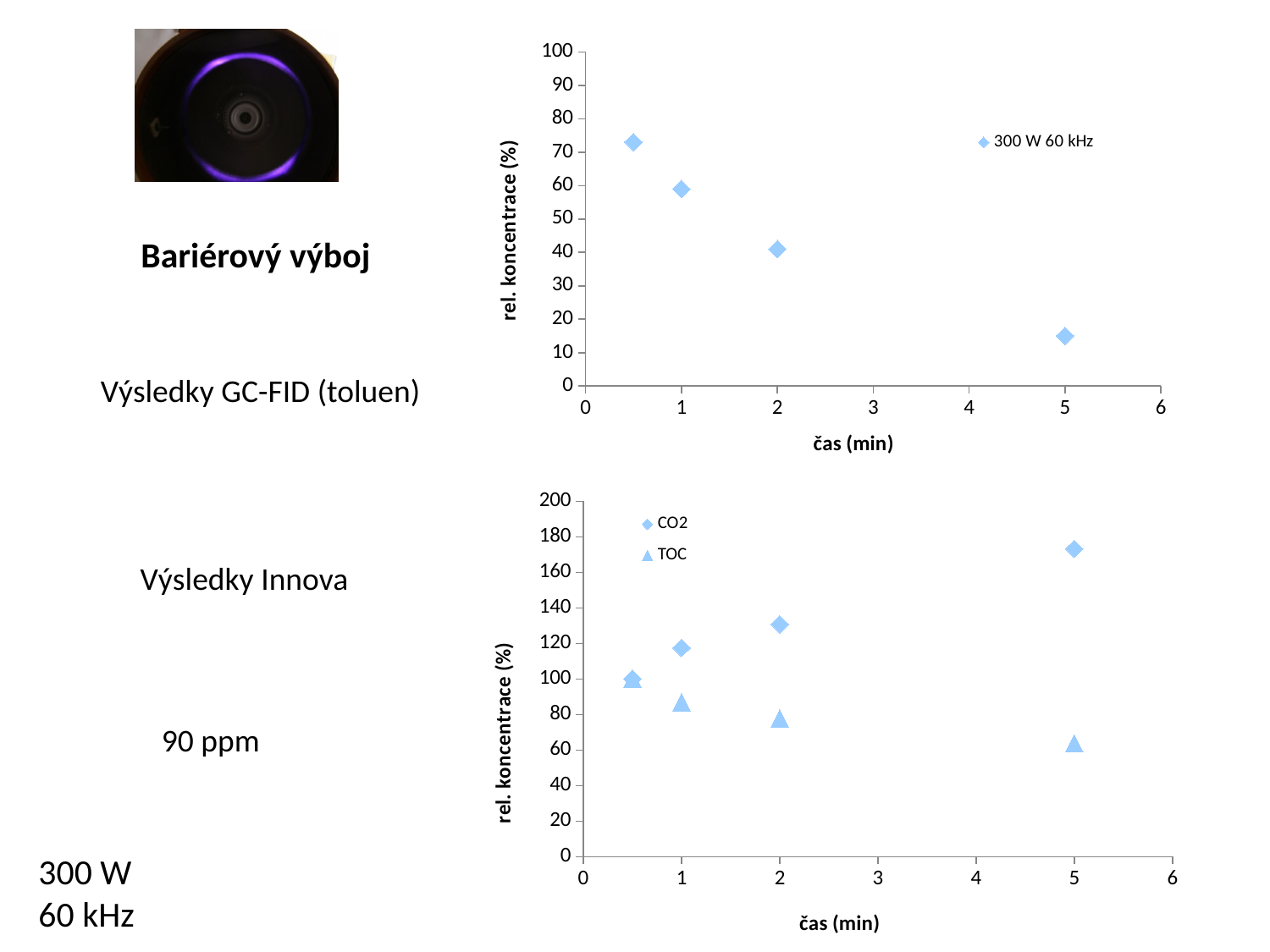
In the bottom chart, is the CO2 value at 5 min greater or less than 160? greater How many series does the legend of the bottom chart list? 2 What is the name of the series in the top chart's legend? 300 W 60 kHz In the top chart, is the value at 5 min greater or less than 20? less What is the x-axis title of the bottom chart? čas (min) What kind of chart is the top chart on the slide? scatter chart In the top chart, is the value at 0.5 min greater or less than 70? greater In the bottom chart, which series has the larger value at 2 min, CO2 or TOC? CO2 In the bottom chart, do the CO2 values rise or fall as time increases? rise How many data points are plotted in the top chart? 4 In the top chart, do the values rise or fall as time (čas) increases? fall How many series does the legend of the top chart list? 1